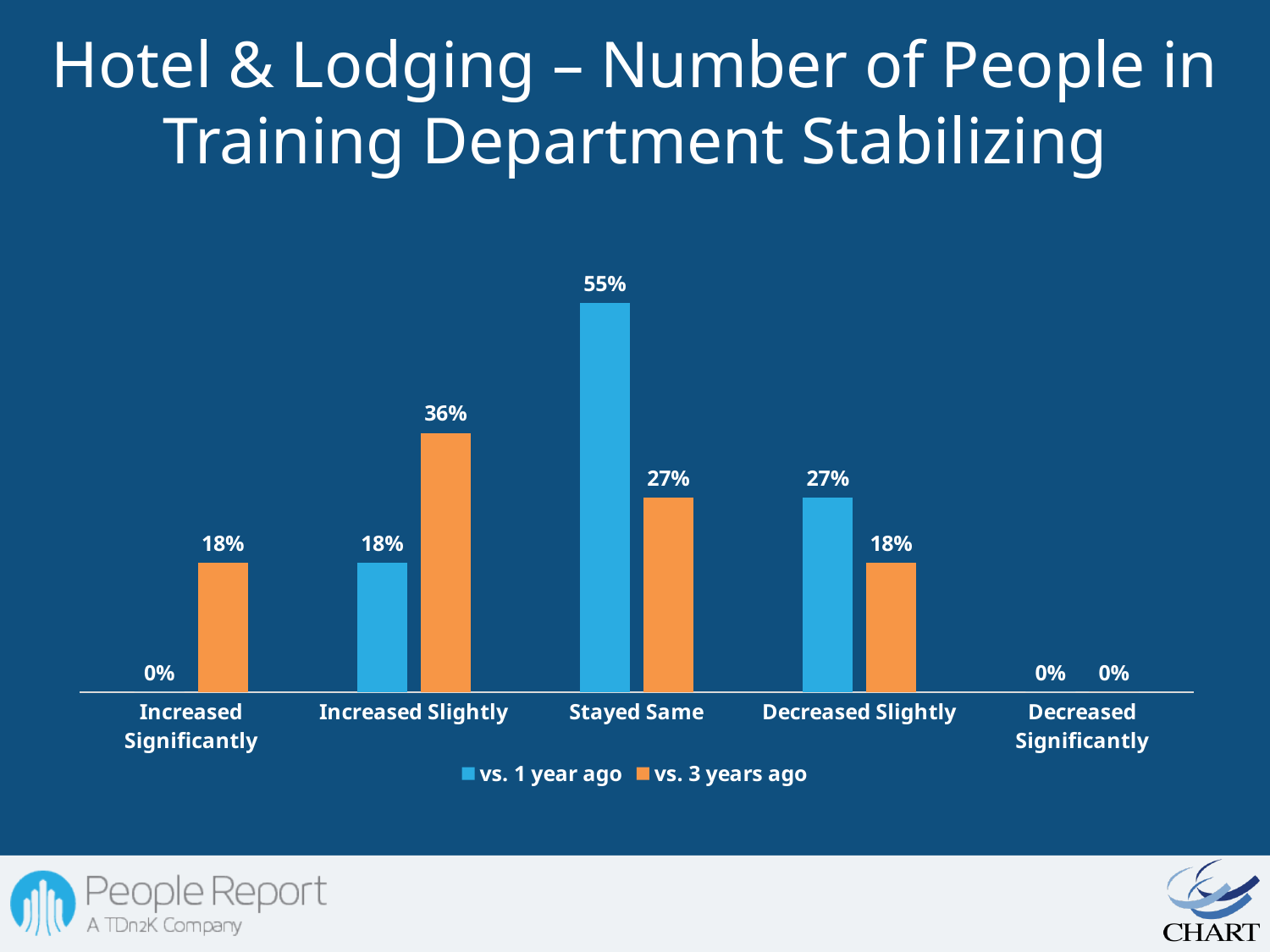
How many categories are shown on the x axis? 5 What is the value for "Decreased Slightly" in the "vs. 3 years ago" series? 18% What kind of chart is shown on the slide? Bar chart Which category has the highest value in the "vs. 3 years ago" series? Increased Slightly Which category has the highest value in the "vs. 1 year ago" series? Stayed Same What is the value for "Increased Significantly" in the "vs. 1 year ago" series? 0% For "Increased Slightly", which series has the larger value, "vs. 1 year ago" or "vs. 3 years ago"? vs. 3 years ago What is the value for "Stayed Same" in the "vs. 1 year ago" series? 55% How many series does the legend list? 2 What is the value for "Increased Slightly" in the "vs. 3 years ago" series? 36% What is the difference between the "vs. 1 year ago" and "vs. 3 years ago" values for "Stayed Same"? 28% What colour are the bars for the "vs. 3 years ago" series? Orange